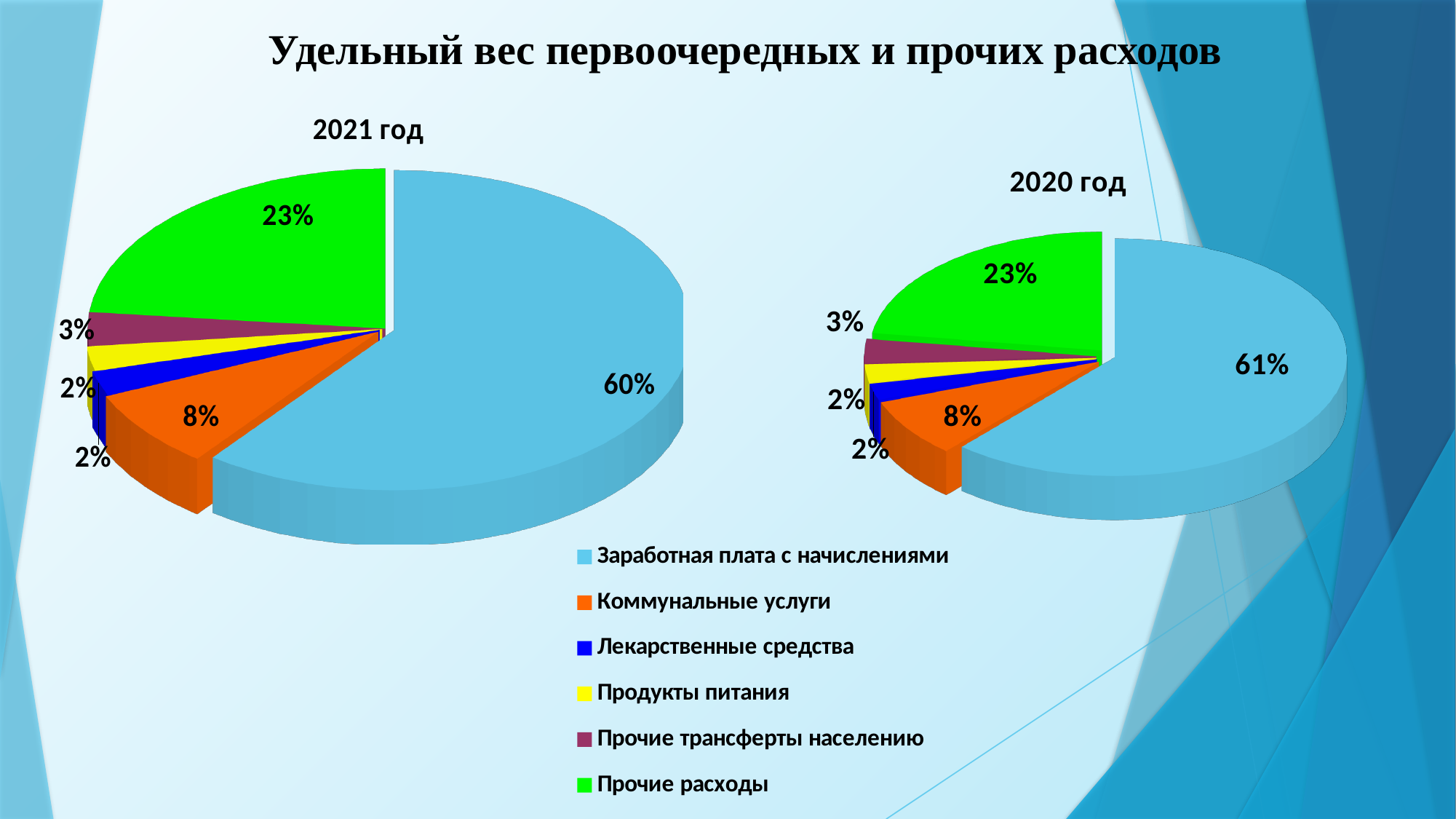
In the 2021 год chart, what is the share of Прочие трансферты населению? 3% In the 2021 год chart, which is larger: Коммунальные услуги or Прочие трансферты населению? Коммунальные услуги In the 2020 год chart, what share does Заработная плата с начислениями have? 61% In the 2020 год chart, what is the share of Коммунальные услуги? 8% In the 2021 год chart, what share does Заработная плата с начислениями have? 60% How many categories does the legend list? 6 In the 2021 год chart, what is the difference between the shares of Прочие расходы and Коммунальные услуги? 15% What is the difference between the Заработная плата с начислениями share in the 2020 год chart and in the 2021 год chart? 1% What type of chart is used for the 2021 год chart? pie chart In the 2021 год chart, what is the share of Прочие расходы? 23% Which colour represents Продукты питания in the legend? yellow In the 2020 год chart, which category has the largest slice? Заработная плата с начислениями